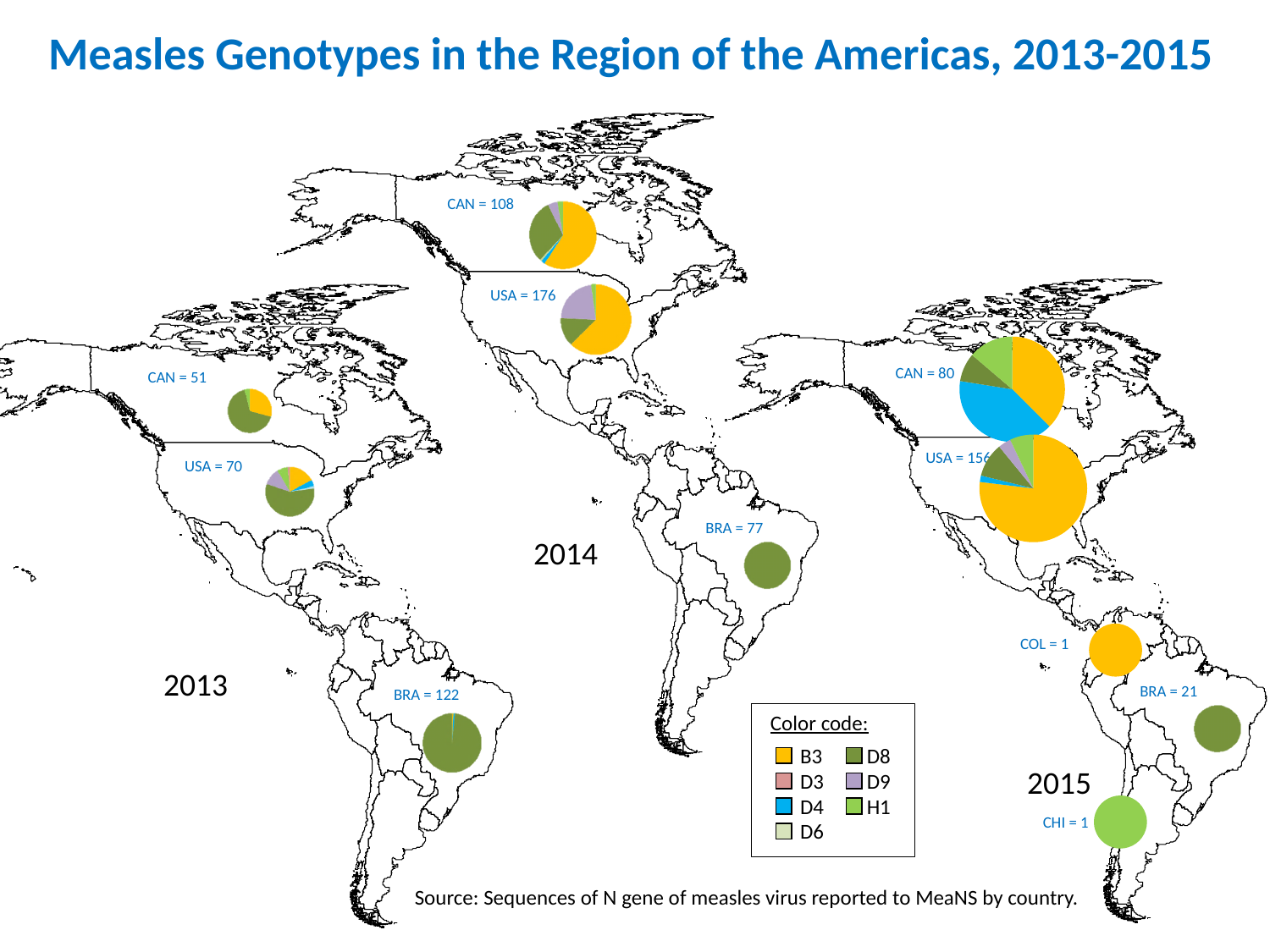
In the 2013 map, which country has the lowest number of sequences? CAN (51) What is the title of the slide? Measles Genotypes in the Region of the Americas, 2013-2015 What is the total number of sequences shown for Brazil (BRA) in the 2013 map? 122 In the 2014 map, which genotype makes up the entire pie for Brazil (BRA = 77)? D8 What is the total number of sequences shown for Canada (CAN) in the 2015 map? 80 Which is larger: the Brazil total in the 2014 map or the Brazil total in the 2015 map? 2014 (77) How many country pie charts are shown on the 2015 map? 5 In the 2015 map, which country has the highest number of sequences? USA (156) What is the total number of sequences shown for the USA in the 2014 map? 176 What is the difference between the USA totals in the 2014 map (176) and the 2013 map (70)? 106 What kind of chart is used to show the genotype distribution for each country? Pie chart How many genotypes are listed in the color code legend? 7